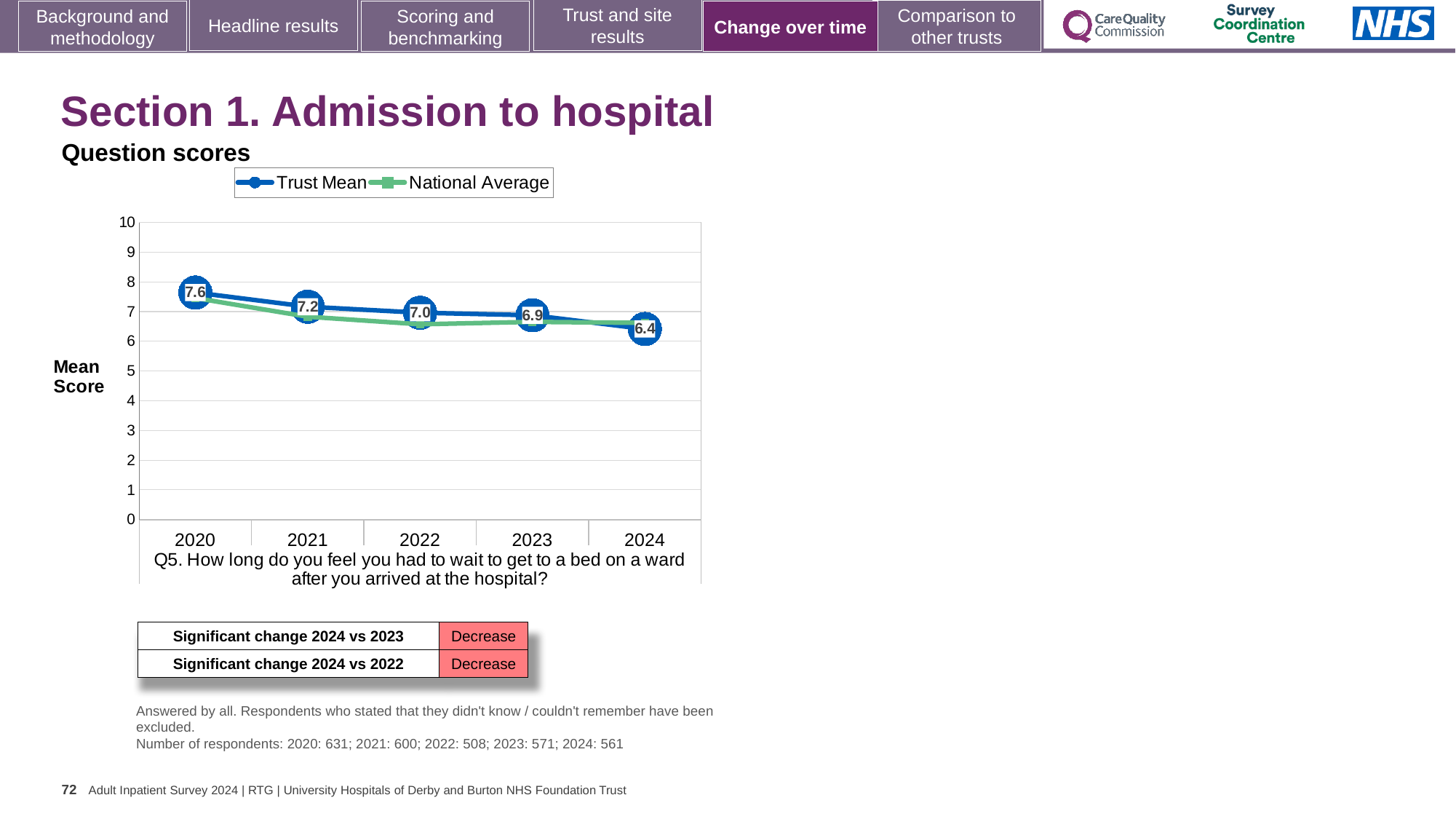
What is the difference between the Trust Mean scores for 2020 and 2024? 1.2 In which year is the Trust Mean score lowest? 2024 What is the Trust Mean score for 2024? 6.4 What is the Trust Mean score for 2020? 7.6 Is the National Average for 2020 greater or less than 7? greater How many years are shown on the x axis of the chart? 5 What kind of chart is shown on the slide? Line chart Which is larger, the Trust Mean score for 2021 or for 2023? 2021 How many series does the chart legend list? 2 Does the Trust Mean score rise or fall from 2020 to 2024? Fall What is the Trust Mean score for 2022? 7.0 In which year is the Trust Mean score highest? 2020